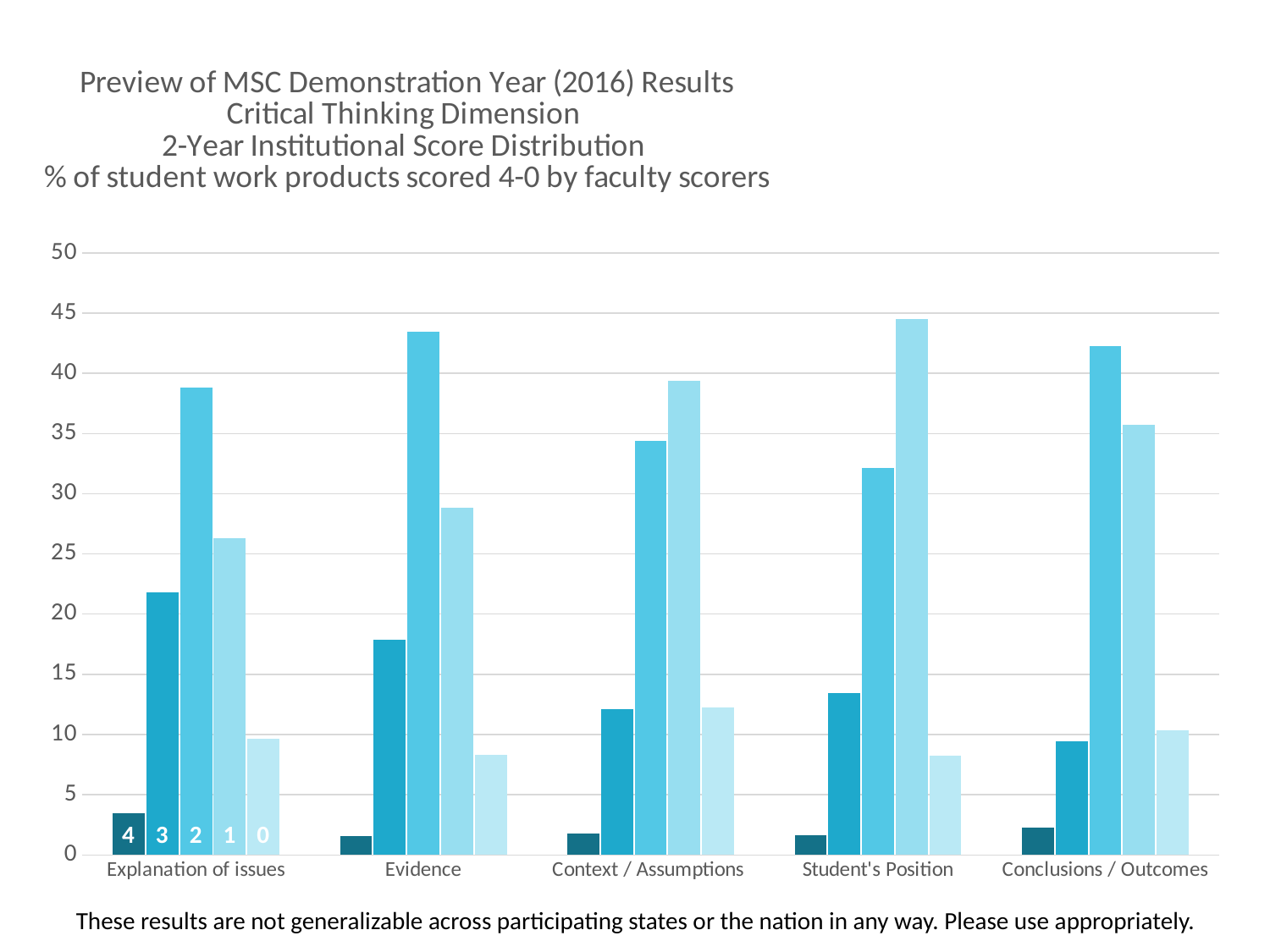
Is the value for score 2 in the Evidence category greater or less than 40? greater Is the value for score 1 in the Student's Position category greater or less than 40? greater Which category has the highest bar for score 3? Explanation of issues In the Context / Assumptions category, which is larger: the bar for score 1 or the bar for score 2? score 1 In the Explanation of issues category, which is larger: the bar for score 2 or the bar for score 1? score 2 Which category has the lowest bar for score 3? Conclusions / Outcomes Which score has the tallest bar in the Student's Position category? 1 Is the value for score 0 in the Conclusions / Outcomes category greater or less than 15? less How many score series (4, 3, 2, 1, 0) are plotted for each category? 5 How many categories are shown along the x axis? 5 What kind of chart is shown on the slide? bar chart